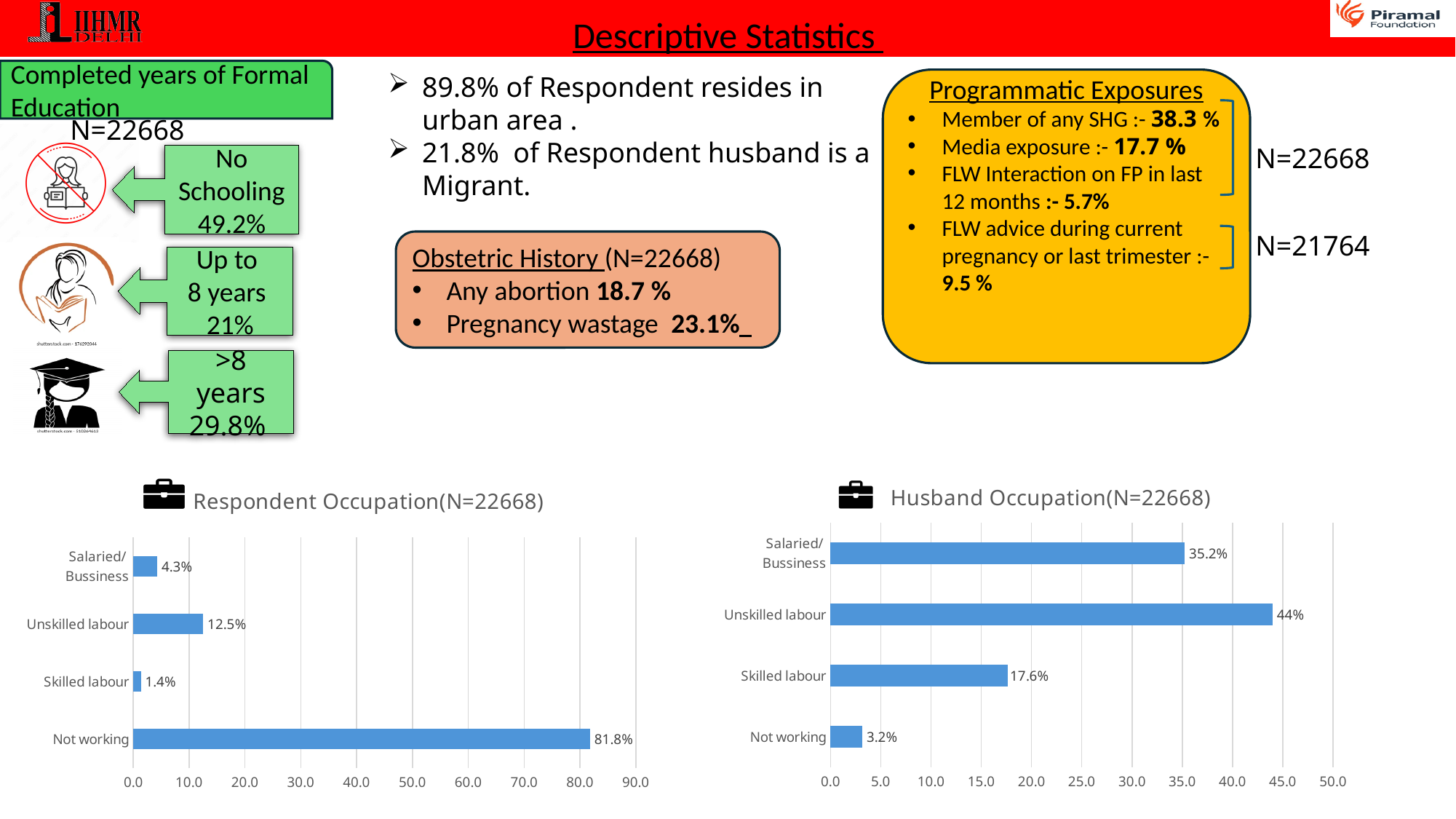
In the Respondent Occupation chart, what is the value for Unskilled labour? 12.5% In the Husband Occupation chart, what is the difference between Unskilled labour and Salaried/Bussiness? 8.8% What kind of chart is the Husband Occupation chart? Bar chart In the Husband Occupation chart, what is the value for Skilled labour? 17.6% In the Respondent Occupation chart, what is the value for Not working? 81.8% How many categories does the Respondent Occupation chart show? 4 In the Respondent Occupation chart, what is the difference between Unskilled labour and Salaried/Bussiness? 8.2% In the Husband Occupation chart, which category has the highest value? Unskilled labour In the Husband Occupation chart, what is the value for Salaried/Bussiness? 35.2% In the Husband Occupation chart, which is larger, Skilled labour or Not working? Skilled labour In the Husband Occupation chart, which category has the lowest value? Not working In the Respondent Occupation chart, which category has the lowest value? Skilled labour